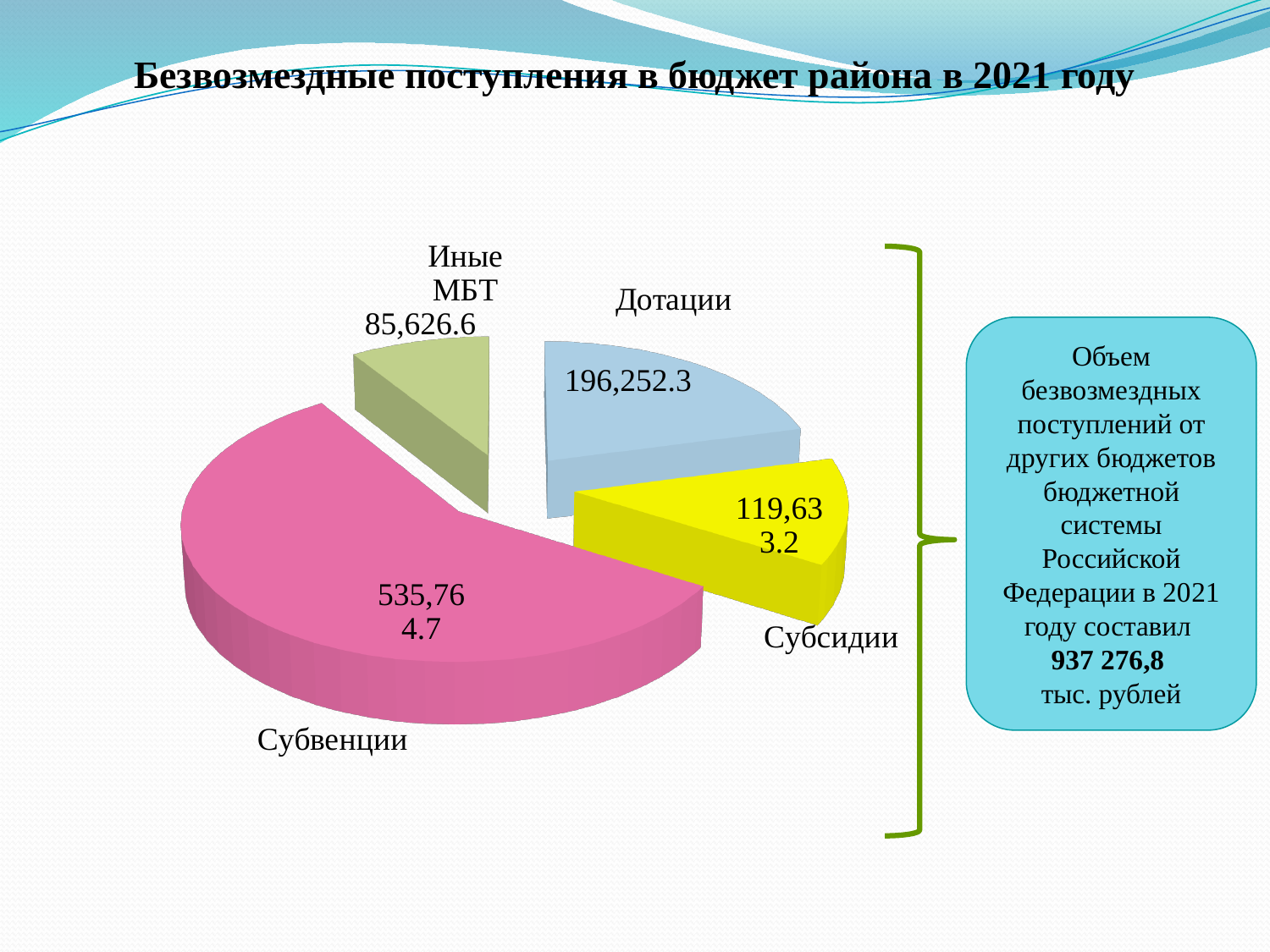
Which is larger, Дотации or Субсидии? Дотации What is the value of the Субсидии slice? 119,633.2 What is the difference between the Субвенции value and the Иные МБТ value? 450,138.1 What is the value of the Субвенции slice? 535,764.7 What is the value of the Дотации slice? 196,252.3 What is the value of the Иные МБТ slice? 85,626.6 What is the title of the slide containing the pie chart? Безвозмездные поступления в бюджет района в 2021 году Which category has the largest slice of the pie? Субвенции What is the difference between the Дотации value and the Субсидии value? 76,619.1 How many slices does the pie chart have? 4 Which category has the smallest slice of the pie? Иные МБТ What type of chart is shown on the slide? Pie chart